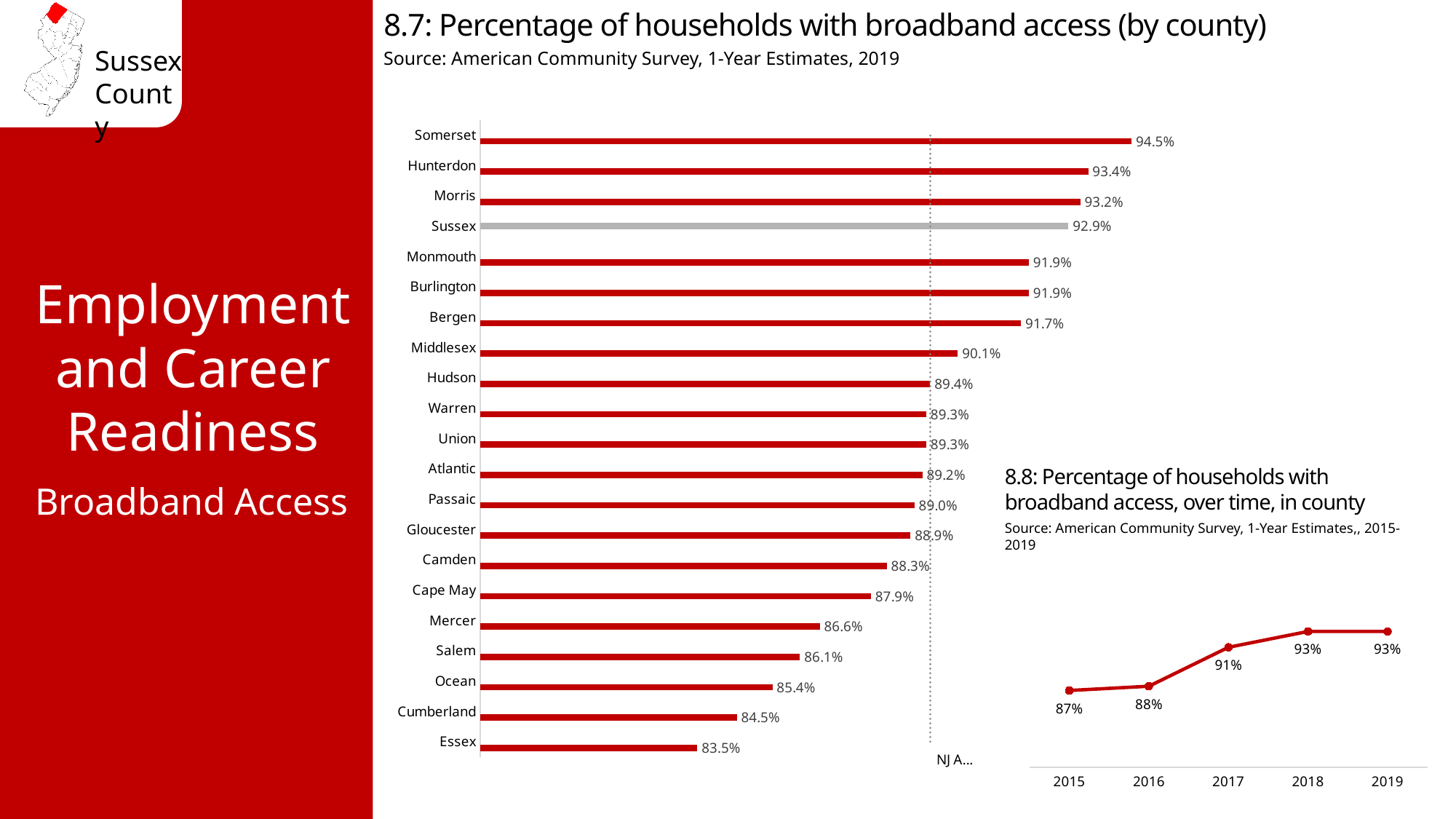
In chart 8.8 (Percentage of households with broadband access over time in county), what is the value for 2017? 91% In chart 8.7 (Percentage of households with broadband access by county), what is the value for Sussex? 92.9% In chart 8.7 (Percentage of households with broadband access by county), how many counties are plotted? 21 In chart 8.8 (Percentage of households with broadband access over time in county), what is the difference between 2019 and 2015? 6% In chart 8.7 (Percentage of households with broadband access by county), what is the value for Cumberland? 84.5% In chart 8.7 (Percentage of households with broadband access by county), which county has the lowest value? Essex In chart 8.7 (Percentage of households with broadband access by county), which is larger, Morris or Middlesex? Morris In chart 8.7 (Percentage of households with broadband access by county), which county has the highest value? Somerset In chart 8.7 (Percentage of households with broadband access by county), which county's bar is shown in grey instead of red? Sussex In chart 8.7 (Percentage of households with broadband access by county), what is the difference between Somerset and Essex? 11.0% In chart 8.8 (Percentage of households with broadband access over time in county), do the values rise or fall from 2015 to 2019? Rise What kind of chart is chart 8.7 (Percentage of households with broadband access by county)? Bar chart